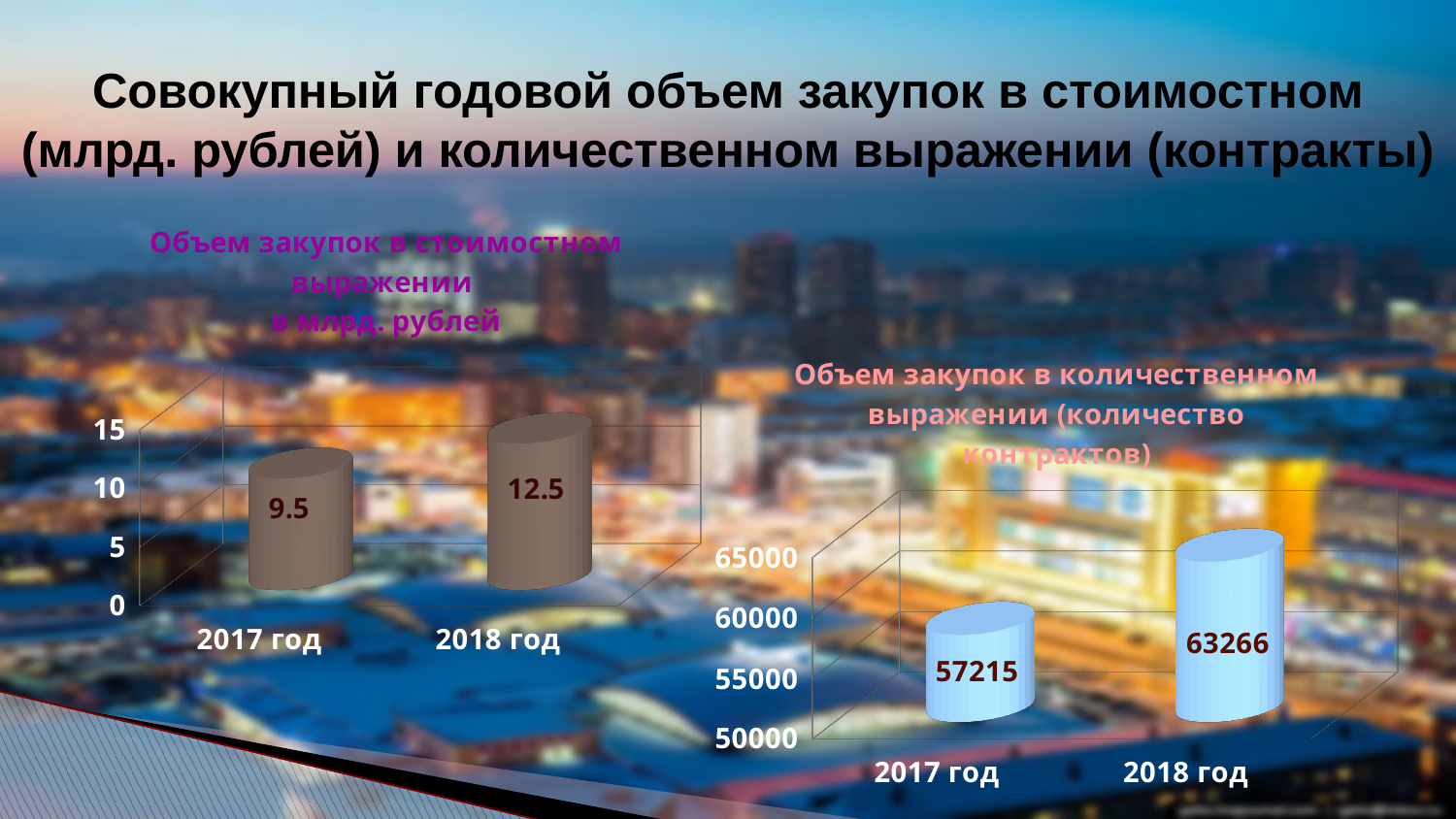
What type of chart is the right chart (Объем закупок в количественном выражении)? bar chart In the left chart (Объем закупок в стоимостном выражении), which year has the highest value? 2018 год In the left chart (Объем закупок в стоимостном выражении), what is the difference between the values for 2018 год and 2017 год? 3 In the right chart (Объем закупок в количественном выражении), what is the value for 2017 год? 57215 In the right chart (Объем закупок в количественном выражении), is the value for 2018 год greater or less than 60000? greater In the right chart (Объем закупок в количественном выражении), what is the value for 2018 год? 63266 In the right chart (Объем закупок в количественном выражении), what is the difference between the values for 2018 год and 2017 год? 6051 In the right chart (Объем закупок в количественном выражении), which year has the lowest value? 2017 год In the left chart (Объем закупок в стоимостном выражении), do the values rise or fall from 2017 год to 2018 год? rise In the left chart (Объем закупок в стоимостном выражении), how many categories are shown? 2 In the left chart (Объем закупок в стоимостном выражении в млрд. рублей), what is the value for 2017 год? 9.5 In the left chart (Объем закупок в стоимостном выражении в млрд. рублей), what is the value for 2018 год? 12.5